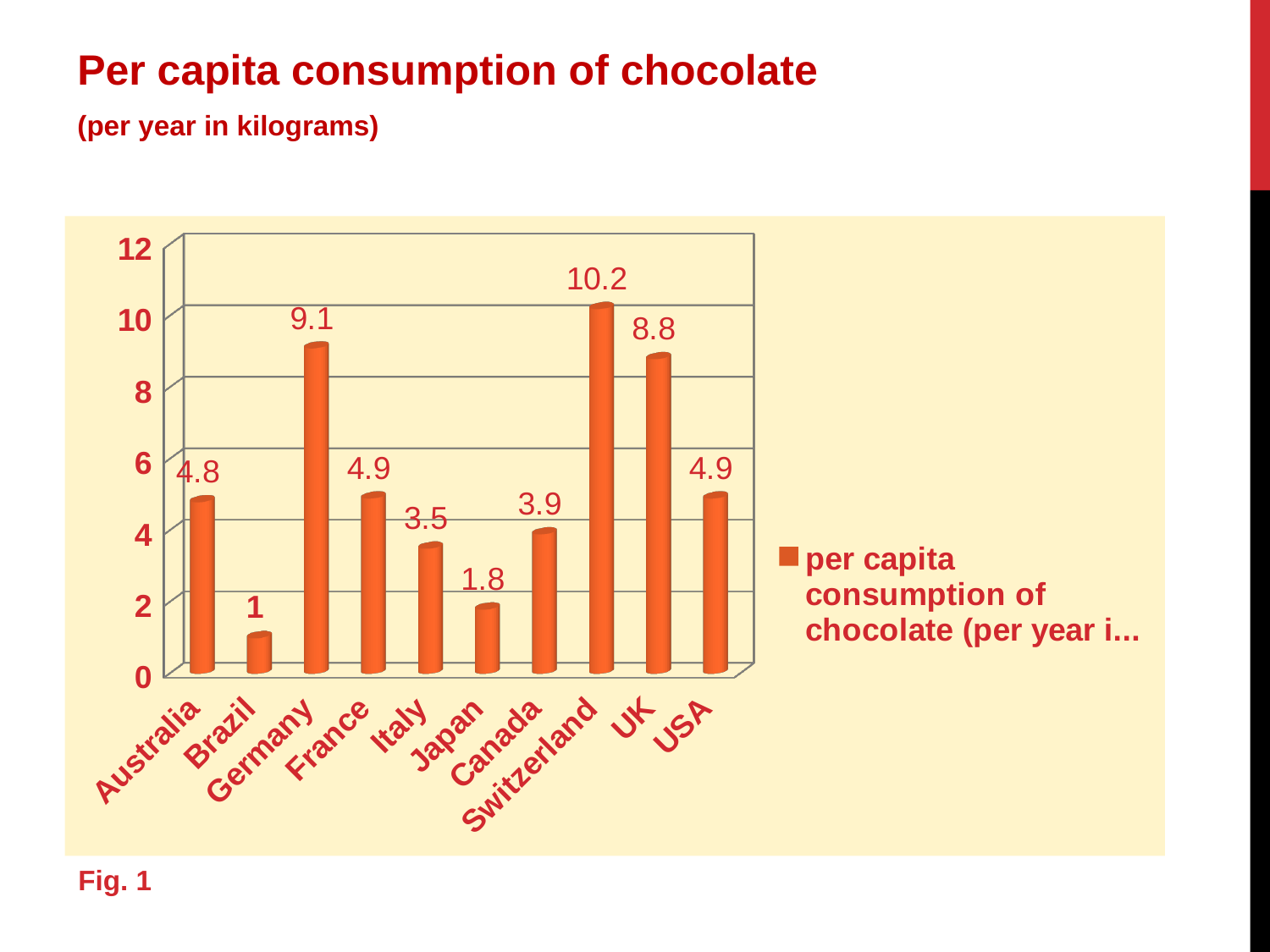
What is the per capita chocolate consumption for Germany? 9.1 What is the difference between the values for Switzerland and the UK? 1.4 Which country has the highest per capita chocolate consumption? Switzerland Which country has the lowest per capita chocolate consumption? Brazil What is the figure label shown below the chart? Fig. 1 What is the per capita chocolate consumption for Switzerland? 10.2 Which has a higher value, Australia or Canada? Australia How many countries are shown in the chart? 10 Is the value for the UK greater or less than 8? greater What kind of chart is shown on the slide? bar chart What is the difference between the values for Germany and Brazil? 8.1 What is the per capita chocolate consumption for Japan? 1.8